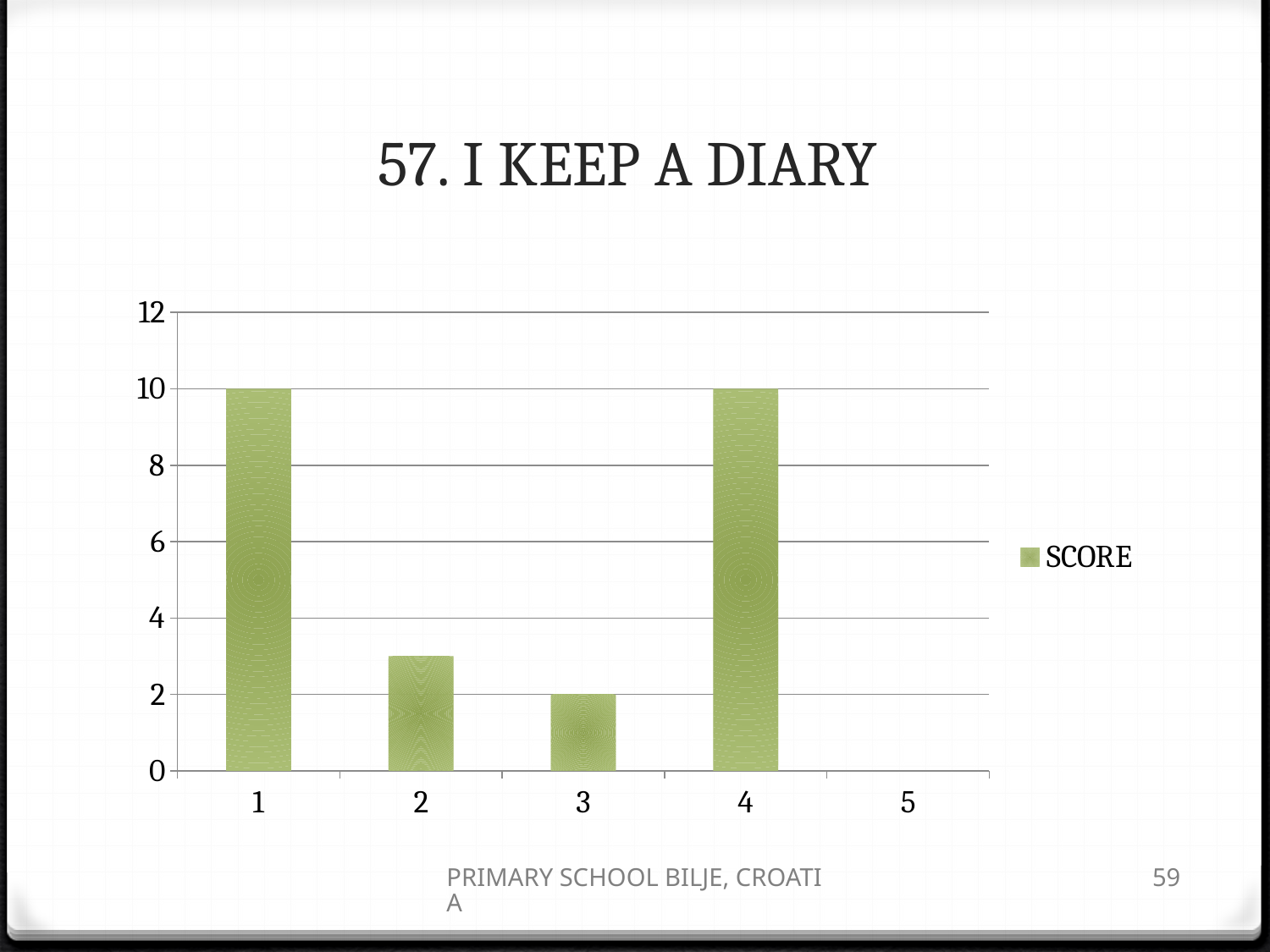
Is the value for category 2 greater or less than 2? greater What is the value for category 5? 0 What kind of chart is shown on the slide? bar chart What is the difference between the values for category 1 and category 3? 8 How many series does the legend list? 1 What is the value for category 4? 10 Which is larger, the value for category 1 or category 2? category 1 Which category has the lowest value? 5 Is the value for category 2 greater or less than 4? less What is the value for category 3? 2 What is the value for category 1? 10 How many categories are shown on the x axis? 5